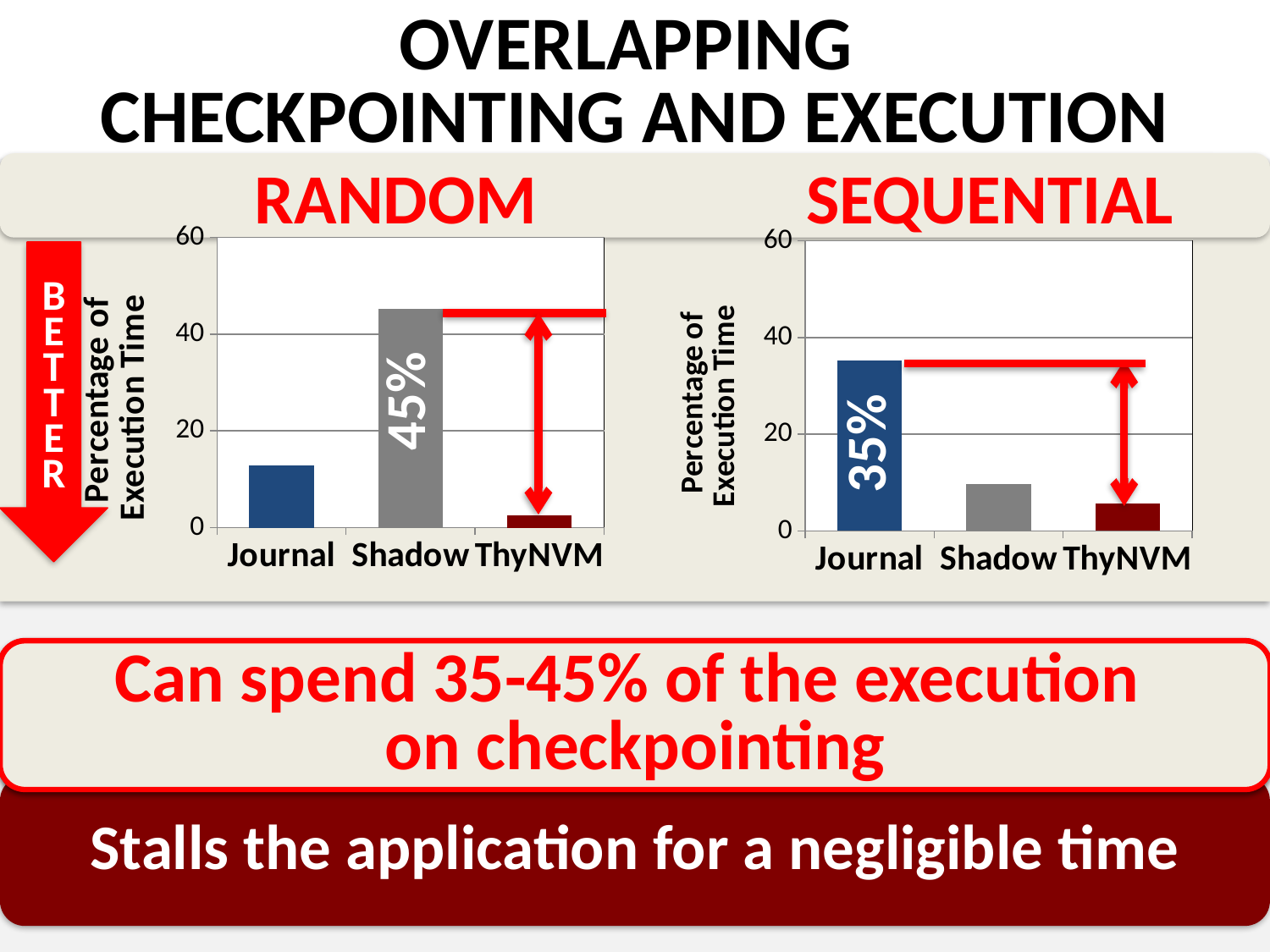
In the RANDOM chart, which category has the lowest percentage of execution time? ThyNVM In the SEQUENTIAL chart, which category has the highest percentage of execution time? Journal In the SEQUENTIAL chart, is the value for Shadow greater or less than 20? less In the RANDOM chart, what is the value for Shadow? 45% In the SEQUENTIAL chart, what is the value for Journal? 35% What is the y-axis title of the SEQUENTIAL chart? Percentage of Execution Time In the RANDOM chart, which is larger, the value for Journal or the value for Shadow? Shadow How many categories are shown in the SEQUENTIAL chart? 3 In the SEQUENTIAL chart, which category has the lowest percentage of execution time? ThyNVM In the RANDOM chart, is the value for Journal greater or less than 20? less What kind of chart is the RANDOM chart? bar chart In the RANDOM chart, which category has the highest percentage of execution time? Shadow